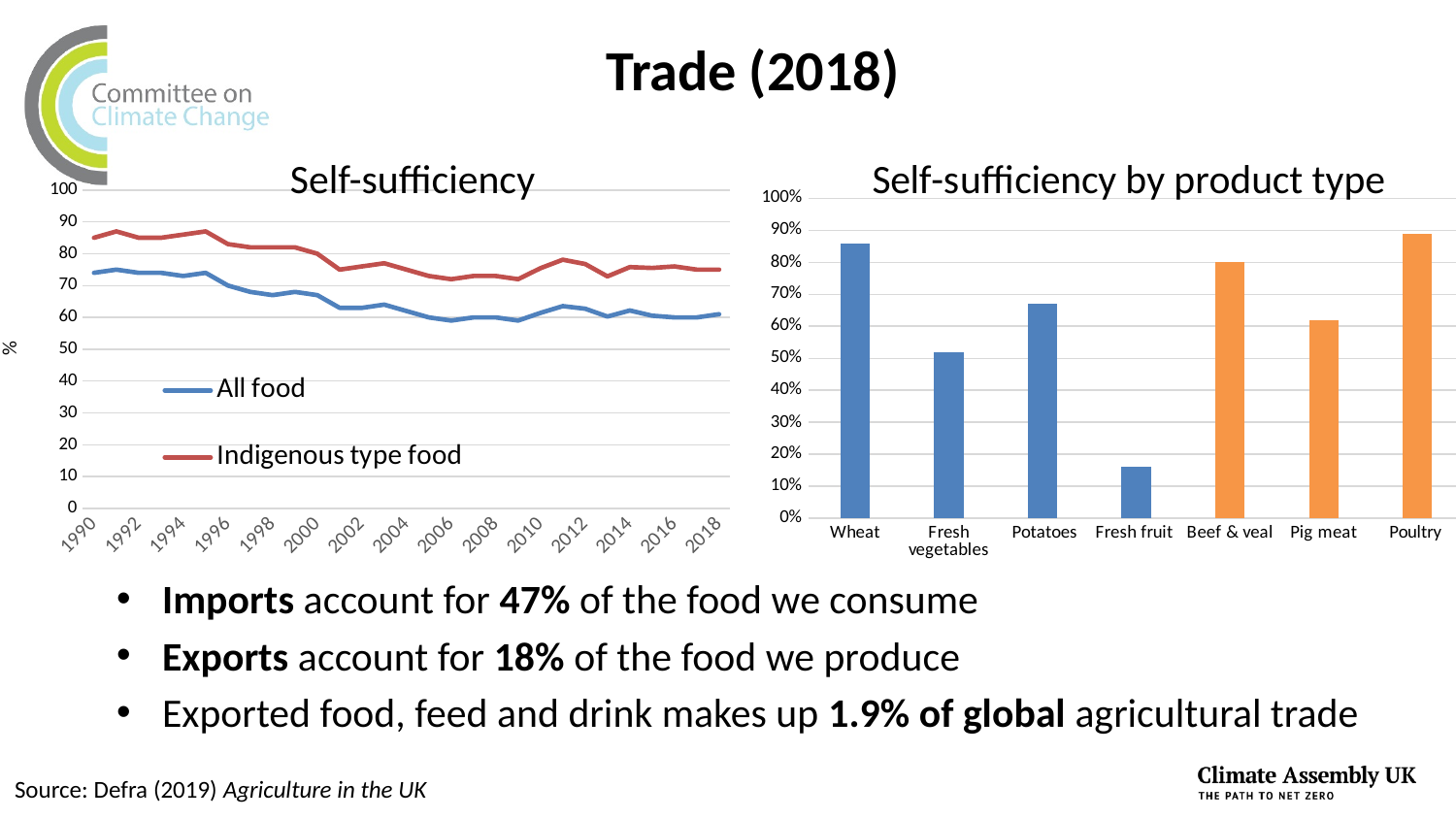
In the 'Self-sufficiency by product type' chart, which product type has the lowest self-sufficiency? Fresh fruit In the 'Self-sufficiency' line chart, how many series does the legend list? 2 In the 'Self-sufficiency' line chart, which series is higher throughout, 'All food' or 'Indigenous type food'? Indigenous type food In the 'Self-sufficiency by product type' chart, is the value for Wheat greater or less than 80%? greater What kind of chart is the 'Self-sufficiency by product type' chart? bar chart In the 'Self-sufficiency' line chart, does the 'All food' series rise or fall from 1990 to 2018? fall In the 'Self-sufficiency by product type' chart, is the value for Fresh fruit greater or less than 20%? less In the 'Self-sufficiency by product type' chart, which is larger, the value for Potatoes or the value for Fresh vegetables? Potatoes In the 'Self-sufficiency by product type' chart, how many product types are shown? 7 In the 'Self-sufficiency' line chart, is the value for 'All food' in 1990 greater or less than 80? less What kind of chart is the 'Self-sufficiency' chart on the left? line chart